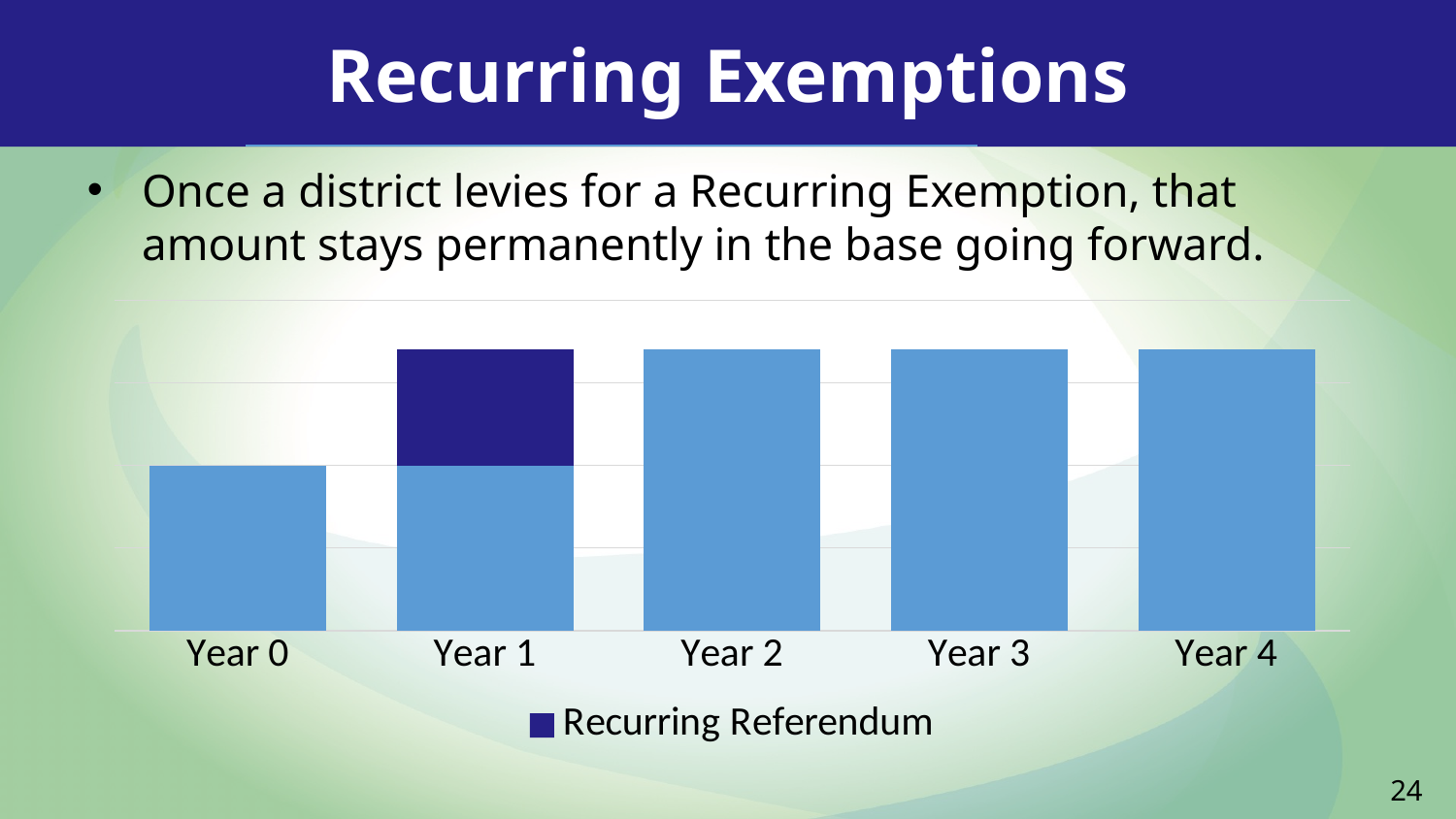
What is the first category label on the x axis? Year 0 What kind of chart is shown on the slide? Bar chart Which bar is taller, Year 0 or Year 2? Year 2 Which year's bar includes a dark blue segment on top? Year 1 What is the last category label on the x axis? Year 4 Does the bar height rise or fall from Year 0 to Year 1? Rise How many categories are shown on the x axis of the chart? 5 Which year has the lowest bar in the chart? Year 0 Which bar is taller, Year 3 or Year 0? Year 3 What is the legend entry shown below the chart? Recurring Referendum How many series does the chart's legend list? 1